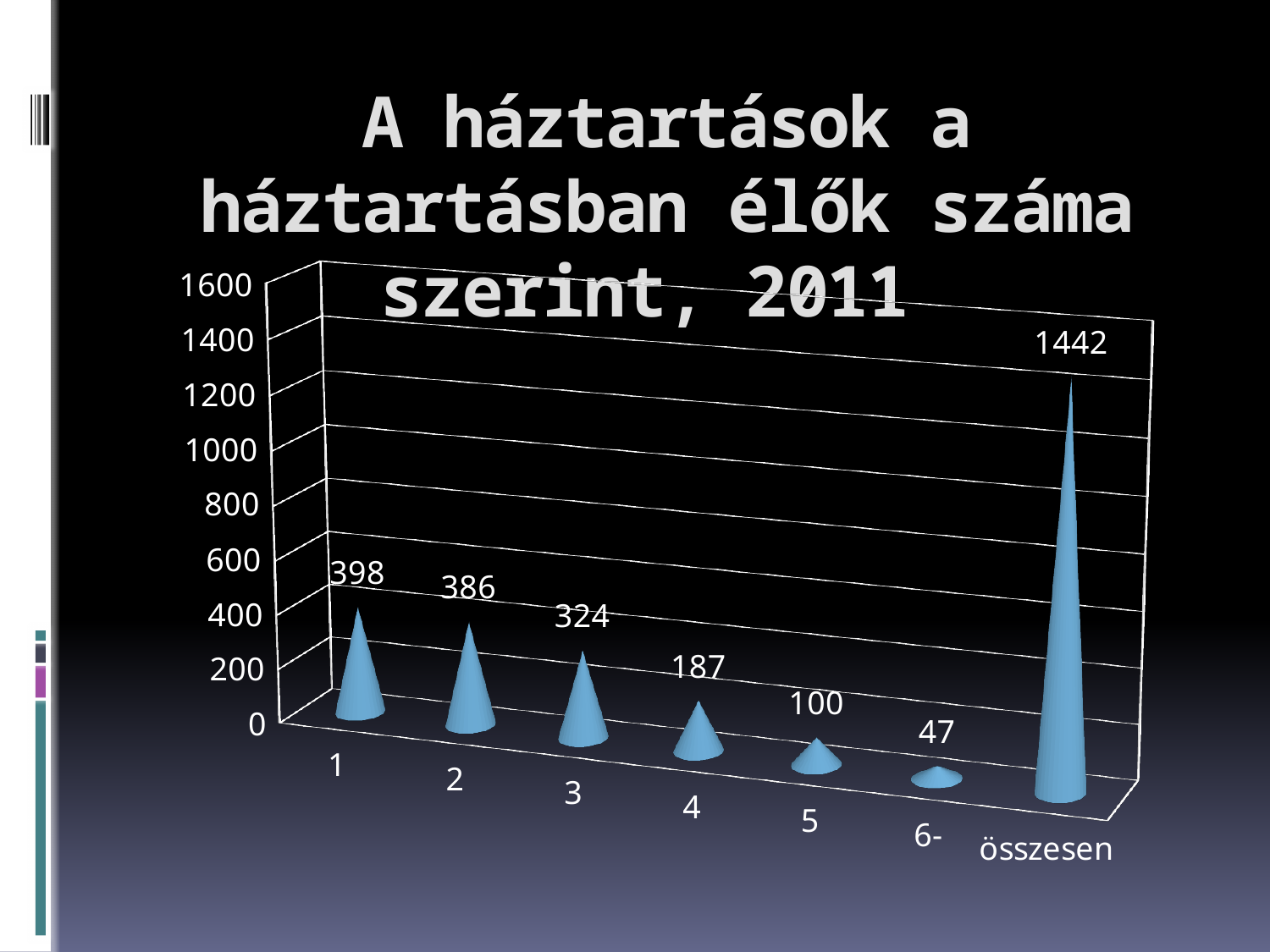
What is the value for category 1? 398 What is the value for category 3? 324 Which category has the highest value? összesen Which is larger, the value for category 2 or category 3? 2 Do the values rise or fall from category 1 to category 6-? fall What is the difference between the values for category 1 and category 2? 12 Which category has the lowest value? 6- What kind of chart is this? bar chart What is the difference between the values for category 4 and category 5? 87 What is the value for category 6-? 47 What is the value for összesen? 1442 How many categories are shown on the x axis? 7